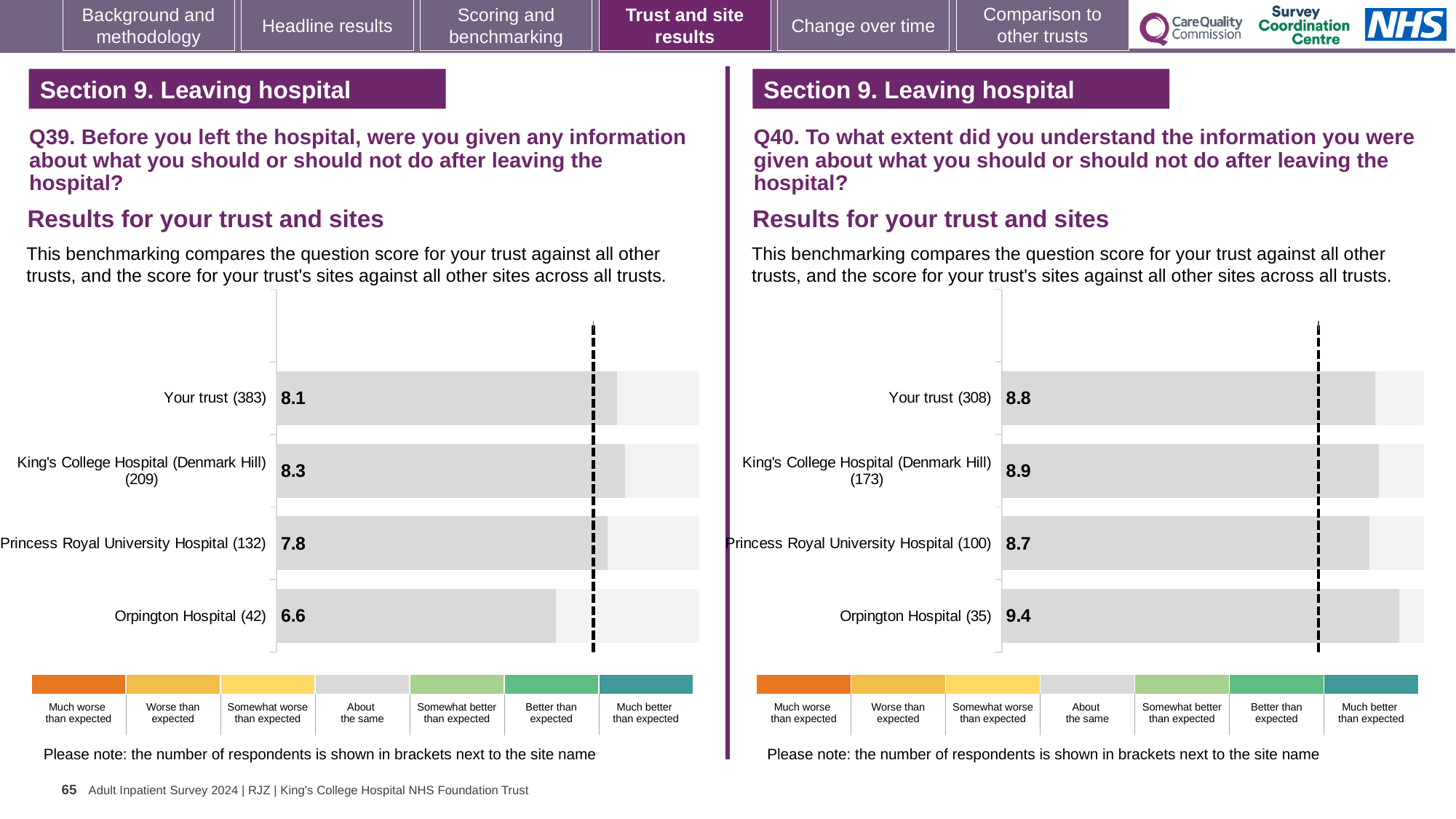
On the Q40 chart (right), what is the score for Princess Royal University Hospital? 8.7 On the Q39 chart (left), what is the difference between the scores for King's College Hospital (Denmark Hill) and Orpington Hospital? 1.7 What type of chart is used on the Q39 chart (left)? Bar chart On the Q39 chart (left), what is the score for King's College Hospital (Denmark Hill)? 8.3 On the Q40 chart (right), which site or trust has the highest score? Orpington Hospital On the Q40 chart (right), what is the score for Your trust? 8.8 On the Q40 chart (right), what is the difference between the scores for Orpington Hospital and Princess Royal University Hospital? 0.7 On the Q39 chart (left), which site or trust has the lowest score? Orpington Hospital On the Q39 chart (left), which has the higher score: Your trust or Princess Royal University Hospital? Your trust On the Q39 chart (left), how many respondents are shown in brackets for Your trust? 383 On the Q39 chart (left), what is the score for Orpington Hospital? 6.6 How many bars are plotted on the Q40 chart (right)? 4